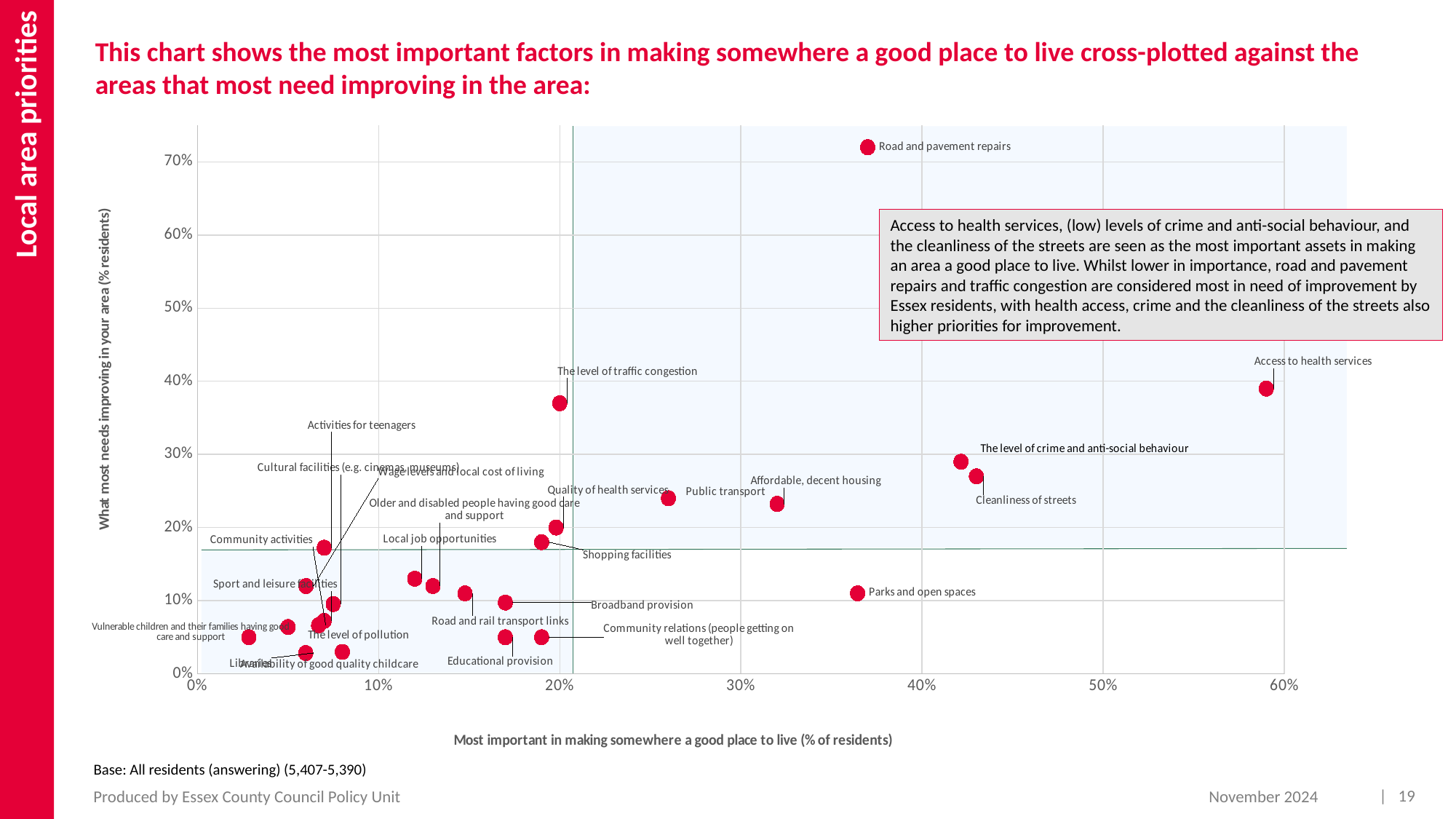
Which factor has the highest value on the horizontal axis (most important in making somewhere a good place to live)? Access to health services What kind of chart is shown on the slide? Scatter chart Which has the larger horizontal-axis value: Access to health services or Road and pavement repairs? Access to health services Is the horizontal-axis value for Affordable, decent housing greater or less than 30%? greater Is the vertical-axis value for Road and pavement repairs greater or less than 60%? greater What is the title of the vertical axis? What most needs improving in your area (% residents) Which factor has the highest value on the vertical axis (what most needs improving)? Road and pavement repairs Is the horizontal-axis value for Access to health services greater or less than 50%? greater What is the title of the horizontal axis? Most important in making somewhere a good place to live (% of residents) Which has the larger vertical-axis value: The level of traffic congestion or Parks and open spaces? The level of traffic congestion